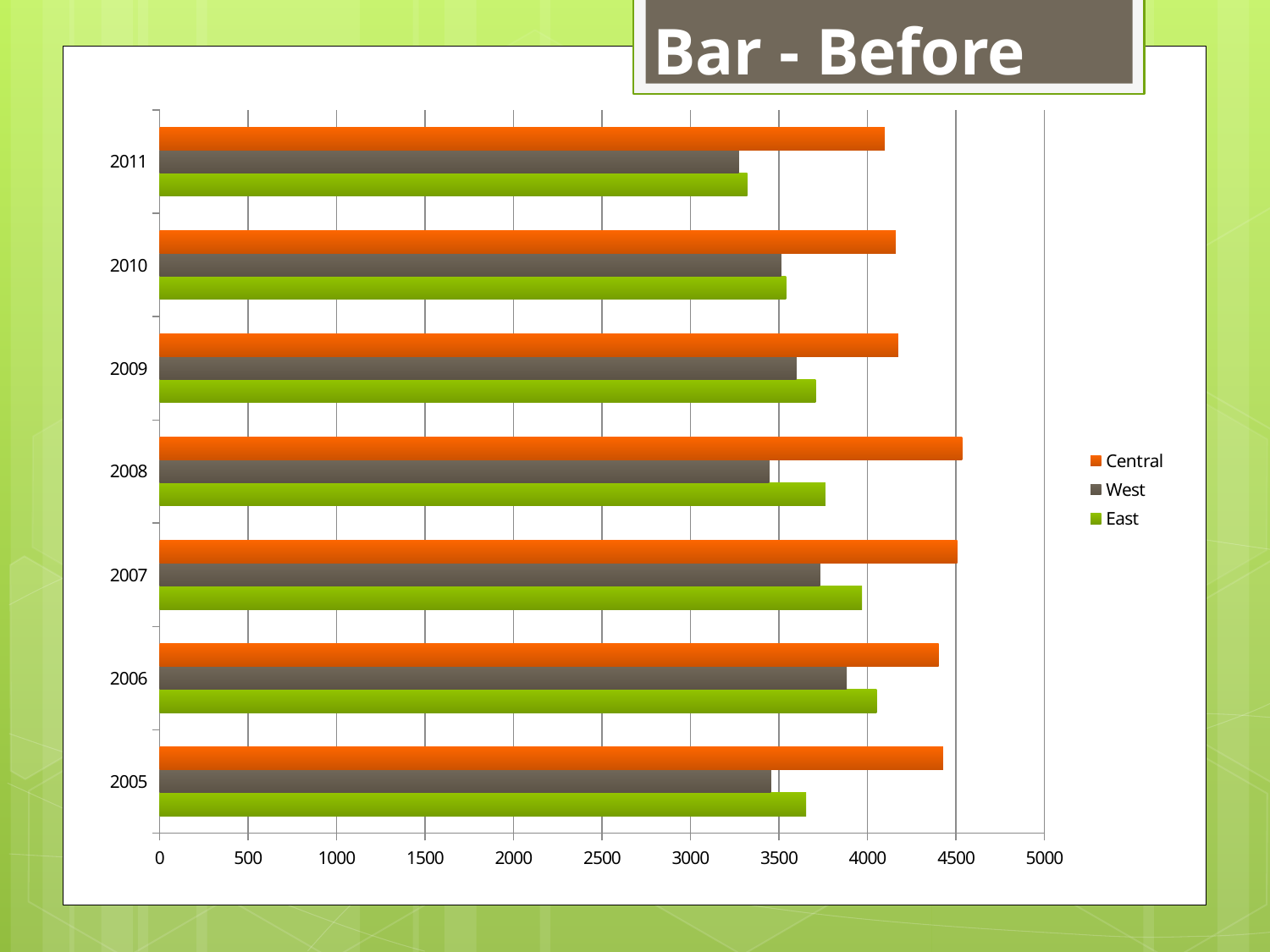
How many years are shown on the vertical axis? 7 Is the value for West in 2006 greater or less than 4000? less Which series is shown in green? East Is the value for East in 2008 greater or less than 3500? greater How many series does the legend list? 3 Is the value for West in 2011 greater or less than 3500? less In 2007, which series has the highest value? Central What is the title of the slide? Bar - Before In 2008, which is larger, the value for East or the value for West? East What kind of chart is shown on the slide? bar chart